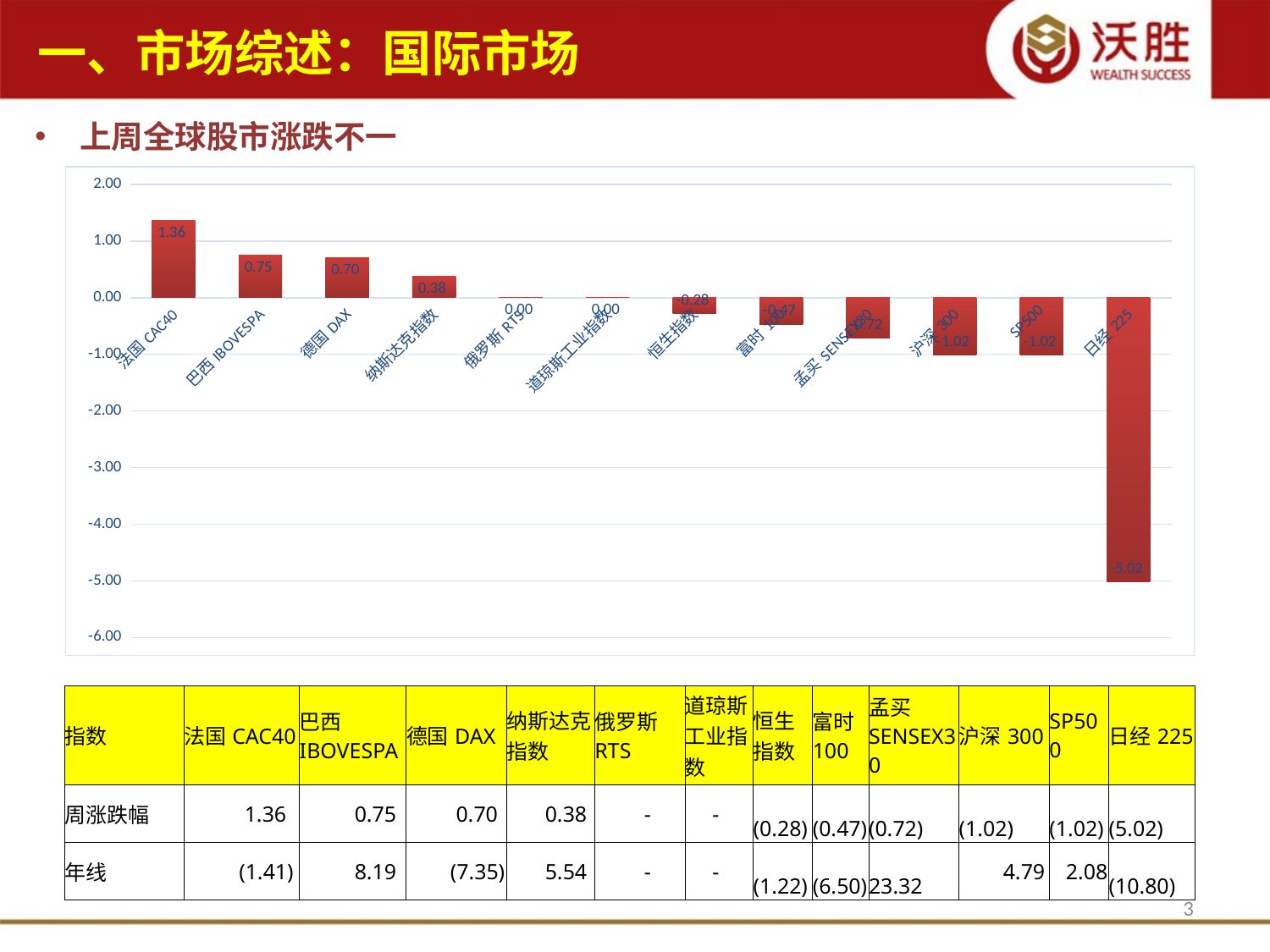
What is the value shown for 德国 DAX in the chart? 0.70 What is the difference between the values for 法国 CAC40 and 巴西 IBOVESPA? 0.61 How many indices (categories) are plotted in the chart? 12 What is the value shown for 日经 225 in the chart? -5.02 What type of chart is shown on the slide? bar chart What is the value shown for 法国 CAC40 in the chart? 1.36 Which is larger, the value for 巴西 IBOVESPA or the value for 德国 DAX? 巴西 IBOVESPA Do the values generally rise or fall moving from left to right along the x axis? fall What is the value shown for 纳斯达克指数 in the chart? 0.38 Is the value for 日经 225 greater or less than -4.00? less Which index has the highest value in the chart? 法国 CAC40 Which index has the lowest value in the chart? 日经 225